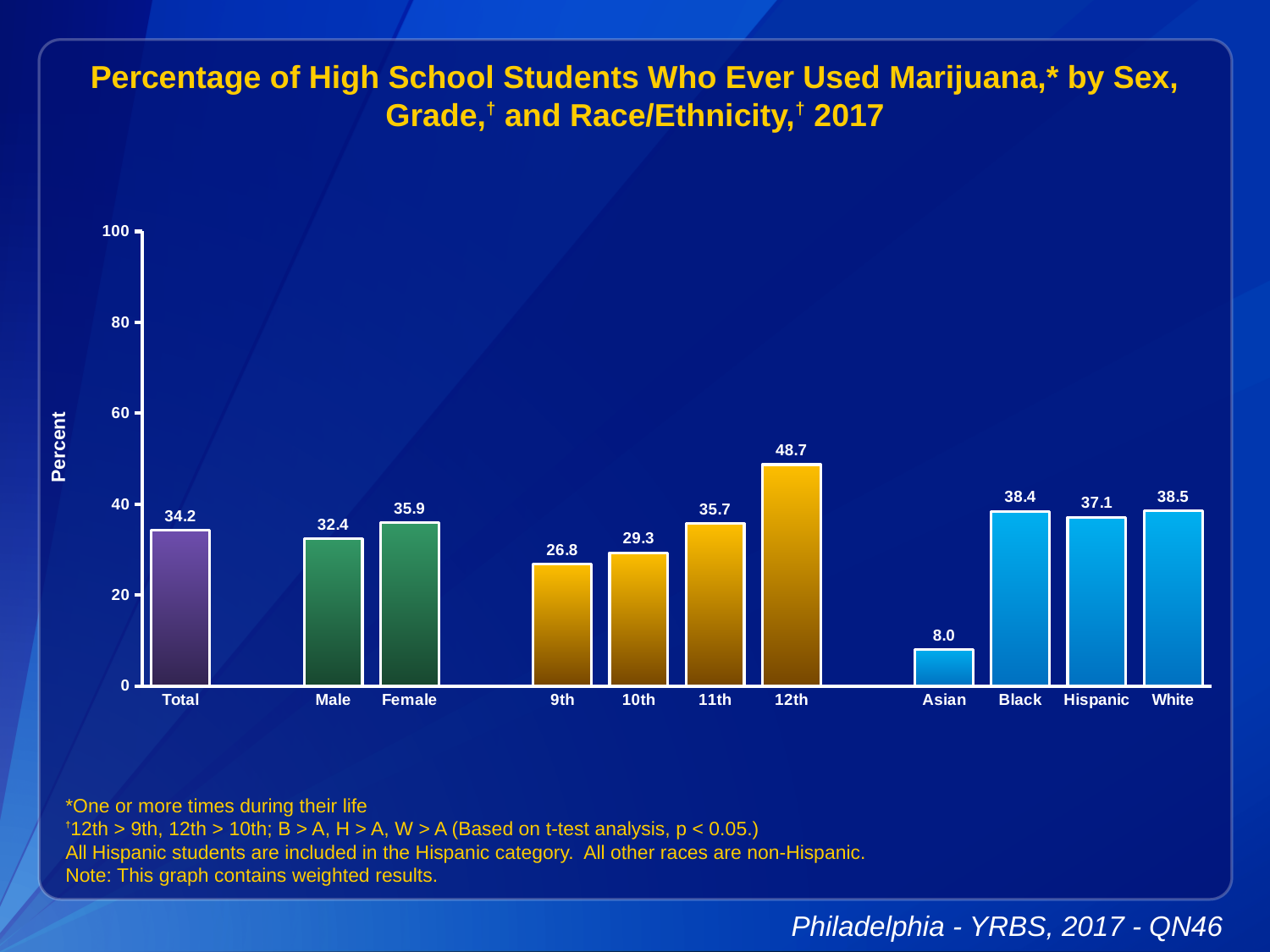
Which category has the lowest value? Asian How many categories are shown on the x axis? 11 Do the values rise or fall from 9th grade to 12th grade? rise What kind of chart is this? bar chart What is the value for Total? 34.2 What is the difference between the Female and Male values? 3.5 What is the label on the y axis? Percent Is the value for 12th grade greater or less than 40? greater Which category has the highest value? 12th What is the value for Asian students? 8.0 Which is larger, the value for 9th grade or 10th grade? 10th What is the value for 12th grade? 48.7